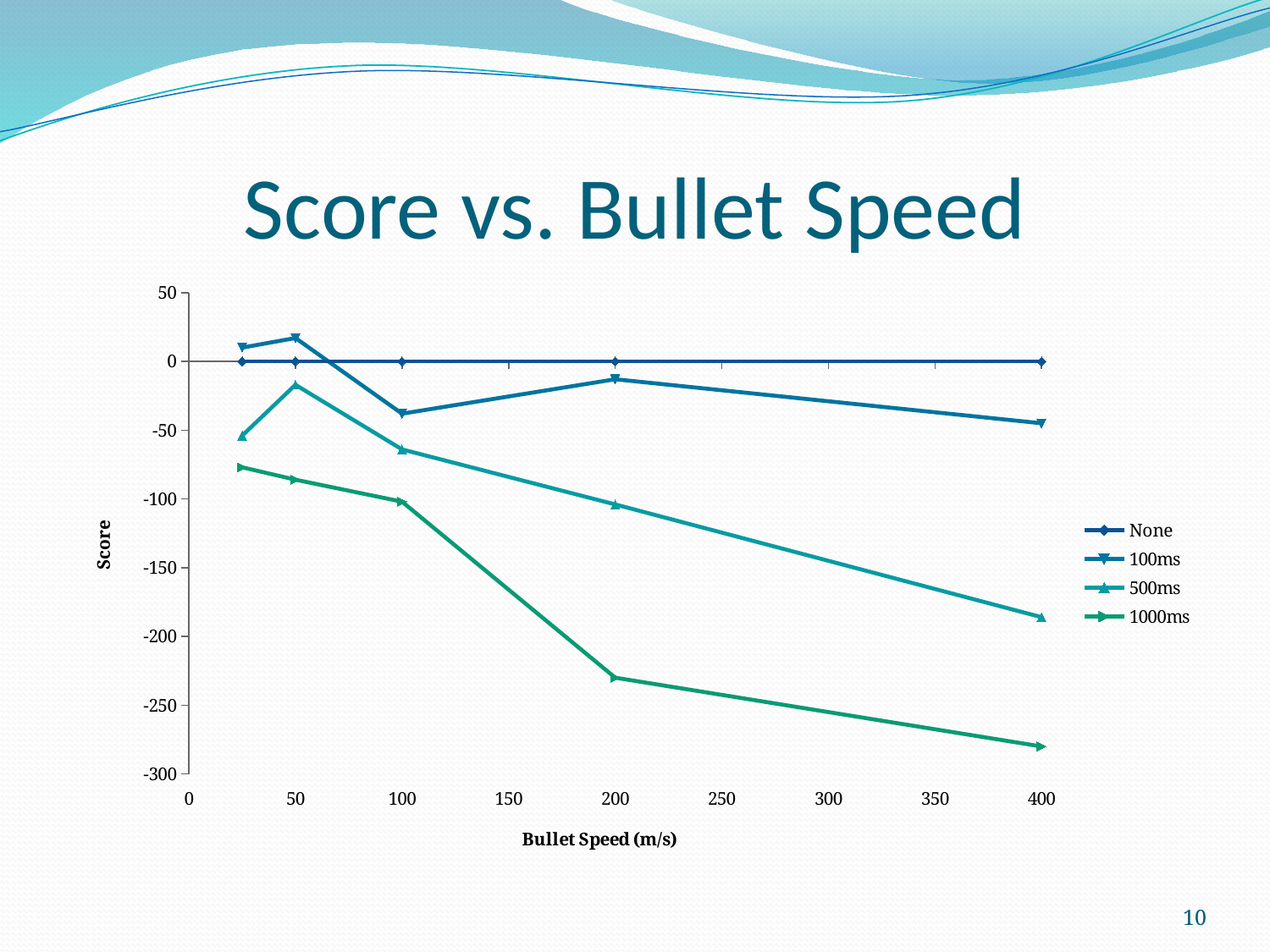
Is the score for the 1000ms series at 200 m/s greater or less than -200? less How many series does the legend list? 4 Does the score for the 1000ms series rise or fall as bullet speed increases? fall Which series has the highest score at a bullet speed of 400 m/s? None What is the score for the None series at a bullet speed of 400 m/s? 0 At a bullet speed of 200 m/s, which series has the higher score, 100ms or 500ms? 100ms Which series has the lowest score at a bullet speed of 400 m/s? 1000ms What is the label of the x axis? Bullet Speed (m/s) Is the score for the 500ms series at 400 m/s greater or less than -150? less Is the score for the 1000ms series at 400 m/s greater or less than -250? less What kind of chart is shown on the slide? line chart What is the title of the chart? Score vs. Bullet Speed